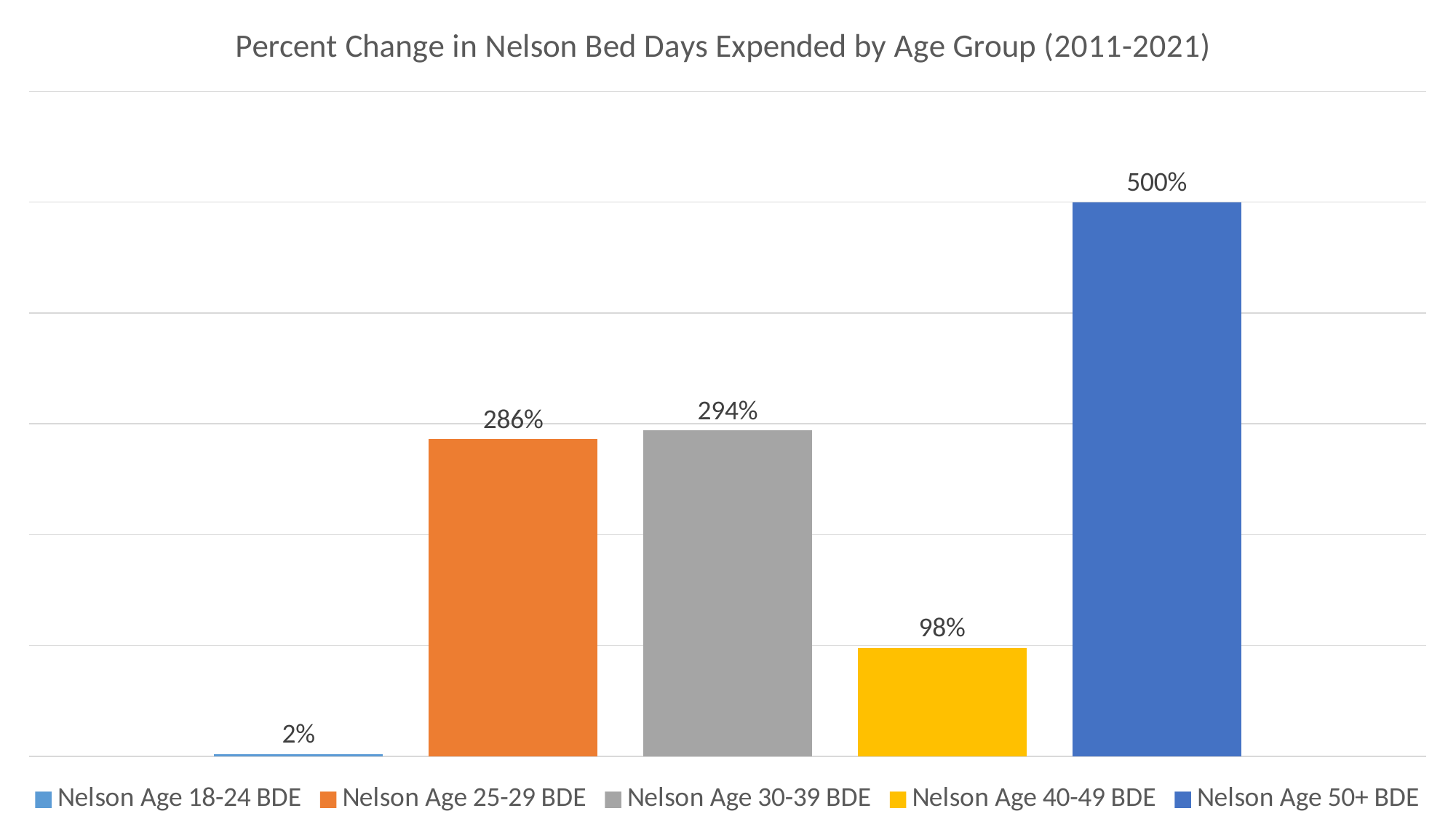
What is the percent change for Nelson Age 40-49 BDE? 98% What is the difference between the percent change for Nelson Age 50+ BDE and Nelson Age 40-49 BDE? 402% What is the percent change in bed days expended for Nelson Age 50+ BDE? 500% What kind of chart is shown on the slide? Bar chart How many age groups are plotted in the chart? 5 What is the percent change for Nelson Age 25-29 BDE? 286% Which age group has the lowest percent change in bed days expended? Nelson Age 18-24 BDE What is the title of the chart? Percent Change in Nelson Bed Days Expended by Age Group (2011-2021) What is the difference between the percent change for Nelson Age 30-39 BDE and Nelson Age 25-29 BDE? 8% What is the percent change for Nelson Age 18-24 BDE? 2% Which has a larger percent change, Nelson Age 25-29 BDE or Nelson Age 40-49 BDE? Nelson Age 25-29 BDE Which age group has the highest percent change in bed days expended? Nelson Age 50+ BDE